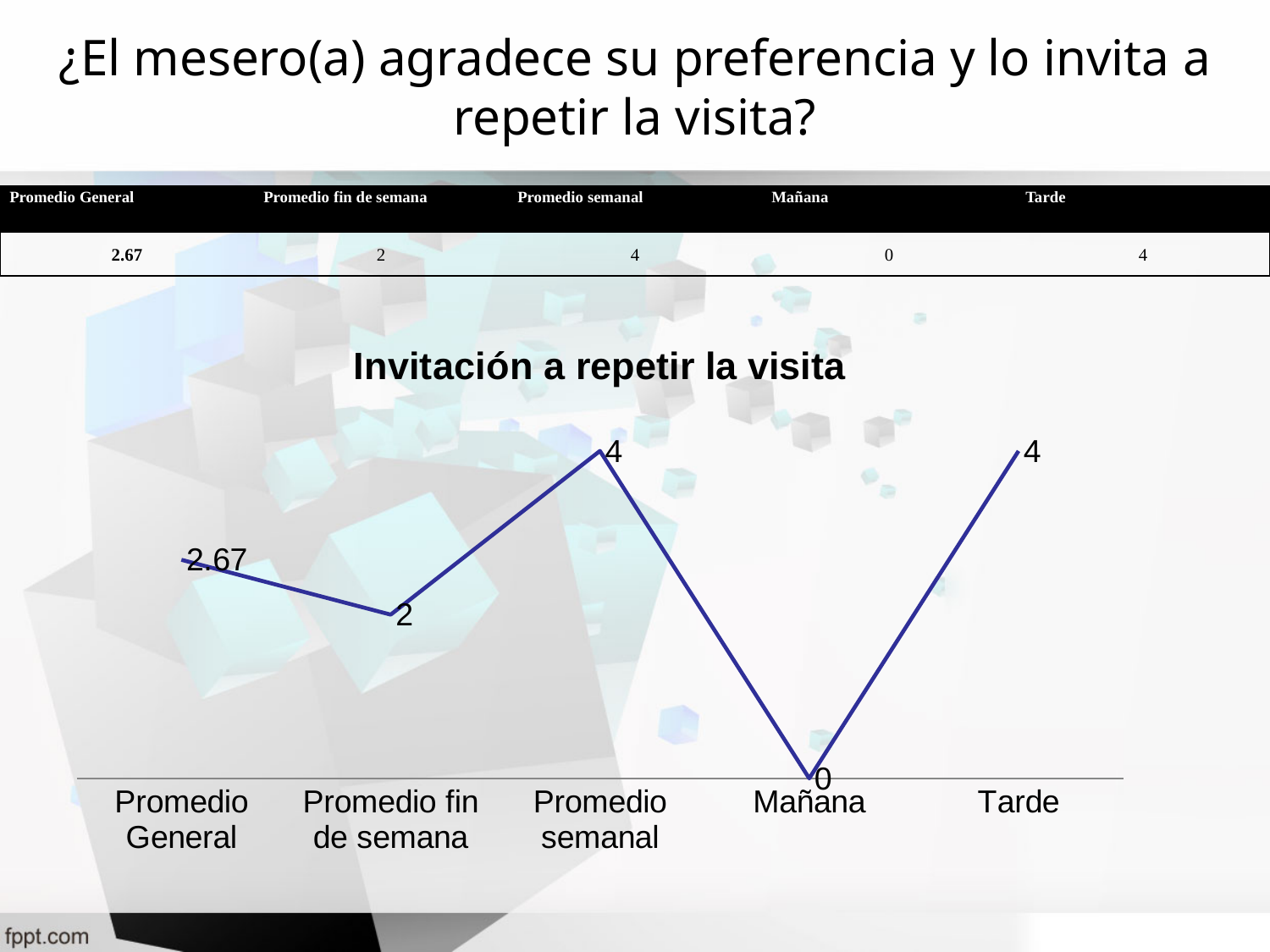
What is the difference between the values for Tarde and Mañana? 4 Which is larger, the value for Promedio General or the value for Promedio fin de semana? Promedio General What is the value for Promedio fin de semana? 2 What is the value for Tarde? 4 What is the title of the chart? Invitación a repetir la visita Which category has the lowest value? Mañana What is the value for Promedio General? 2.67 What kind of chart is shown? line chart How many categories are plotted on the x axis? 5 What is the value for Mañana? 0 Does the value rise or fall from Mañana to Tarde? rise What is the difference between the values for Promedio semanal and Promedio fin de semana? 2